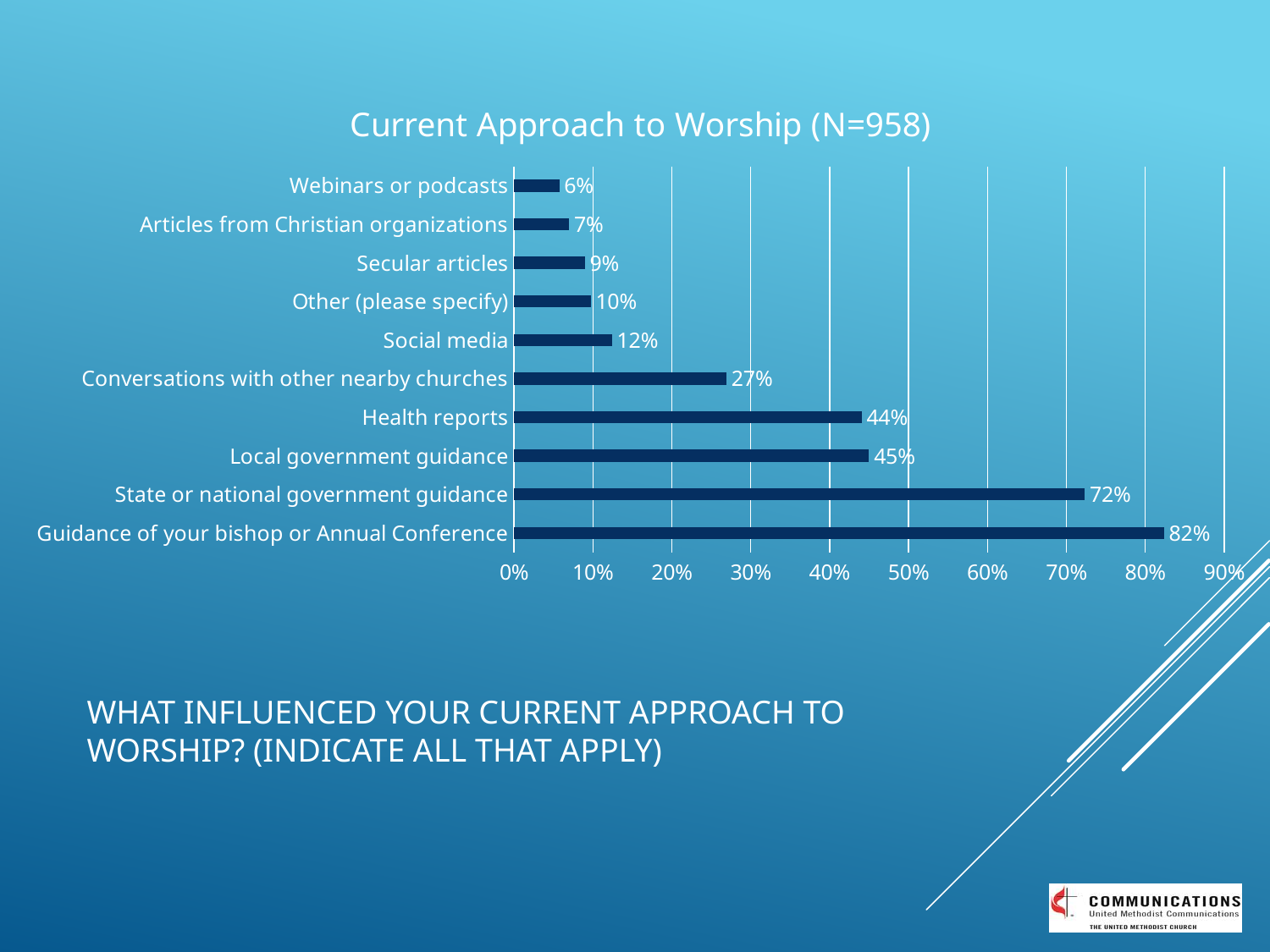
Which category has the lowest value? Webinars or podcasts What kind of chart is shown on the slide? Bar chart What is the difference between State or national government guidance and Local government guidance? 27% What is the value for Social media? 12% What is the value for Health reports? 44% Is the value for State or national government guidance greater or less than 60%? greater How many categories are shown in the chart? 10 What is the title of the chart? Current Approach to Worship (N=958) Which category has the highest value? Guidance of your bishop or Annual Conference What is the value for Guidance of your bishop or Annual Conference? 82% Which is larger, Conversations with other nearby churches or Social media? Conversations with other nearby churches What is the value for Other (please specify)? 10%